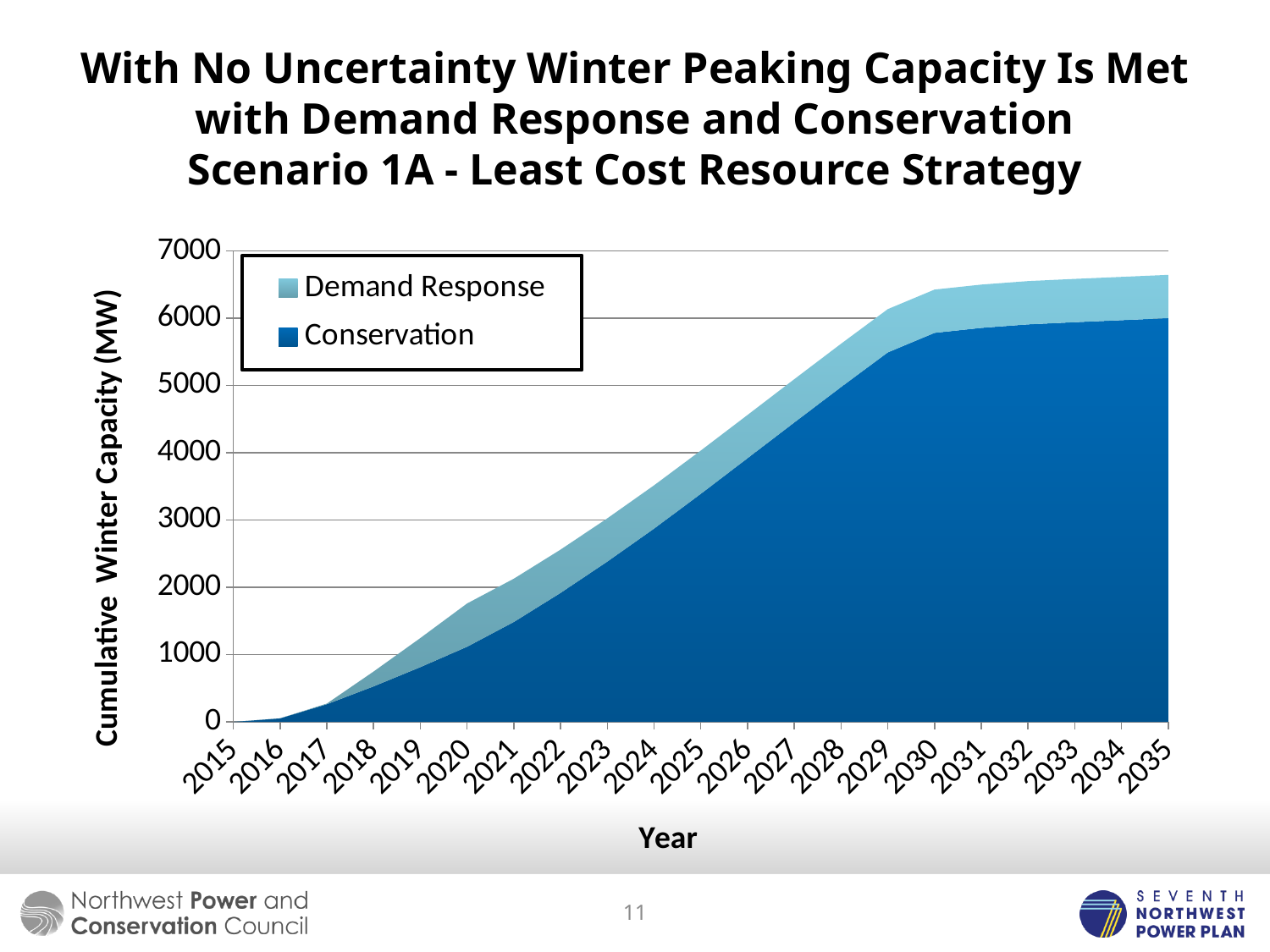
Is the Conservation value in 2030 greater or less than 5000? greater What are the two series named in the legend? Demand Response and Conservation Which series contributes more to the total in 2035, Conservation or Demand Response? Conservation Is the Conservation value in 2018 greater or less than 1000? less Does the Conservation area rise or fall from 2015 to 2035? Rise Is the total cumulative winter capacity in 2024 greater or less than 3000? greater In which year is the total cumulative winter capacity highest? 2035 What is the label of the y axis? Cumulative Winter Capacity (MW) How many years are shown along the x axis? 21 What kind of chart is shown on the slide? Stacked area chart How many series does the legend list? 2